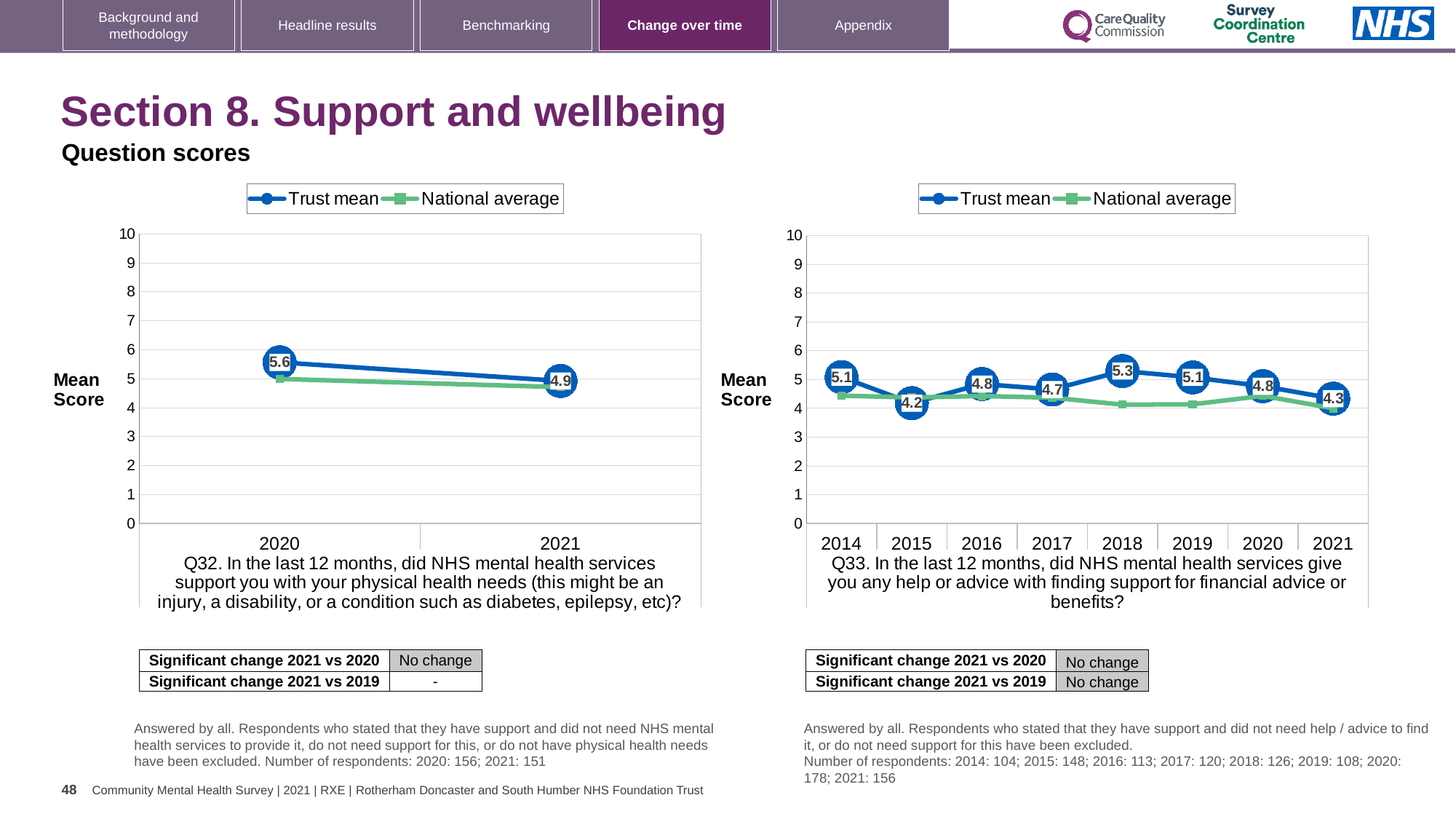
In the Q33 chart on the right, is the National average for 2018 greater or less than 5? less How many series does the legend of the Q32 chart on the left list? 2 In the Q33 chart on the right, what is the difference between the Trust mean in 2018 and in 2021? 1.0 In the Q33 chart on the right, how many years are plotted on the x axis? 8 In the Q33 chart on the right, what is the Trust mean for 2015? 4.2 In the Q33 chart on the right, what is the Trust mean for 2018? 5.3 In the Q32 chart on the left, does the Trust mean rise or fall from 2020 to 2021? fall In the Q32 chart on the left, by how much did the Trust mean fall from 2020 to 2021? 0.7 In the Q32 chart on the left, what is the Trust mean for 2020? 5.6 In the Q33 chart on the right, which year has the lowest Trust mean? 2015 In the Q32 chart on the left, what is the Trust mean for 2021? 4.9 In the Q33 chart on the right, which year has the highest Trust mean? 2018